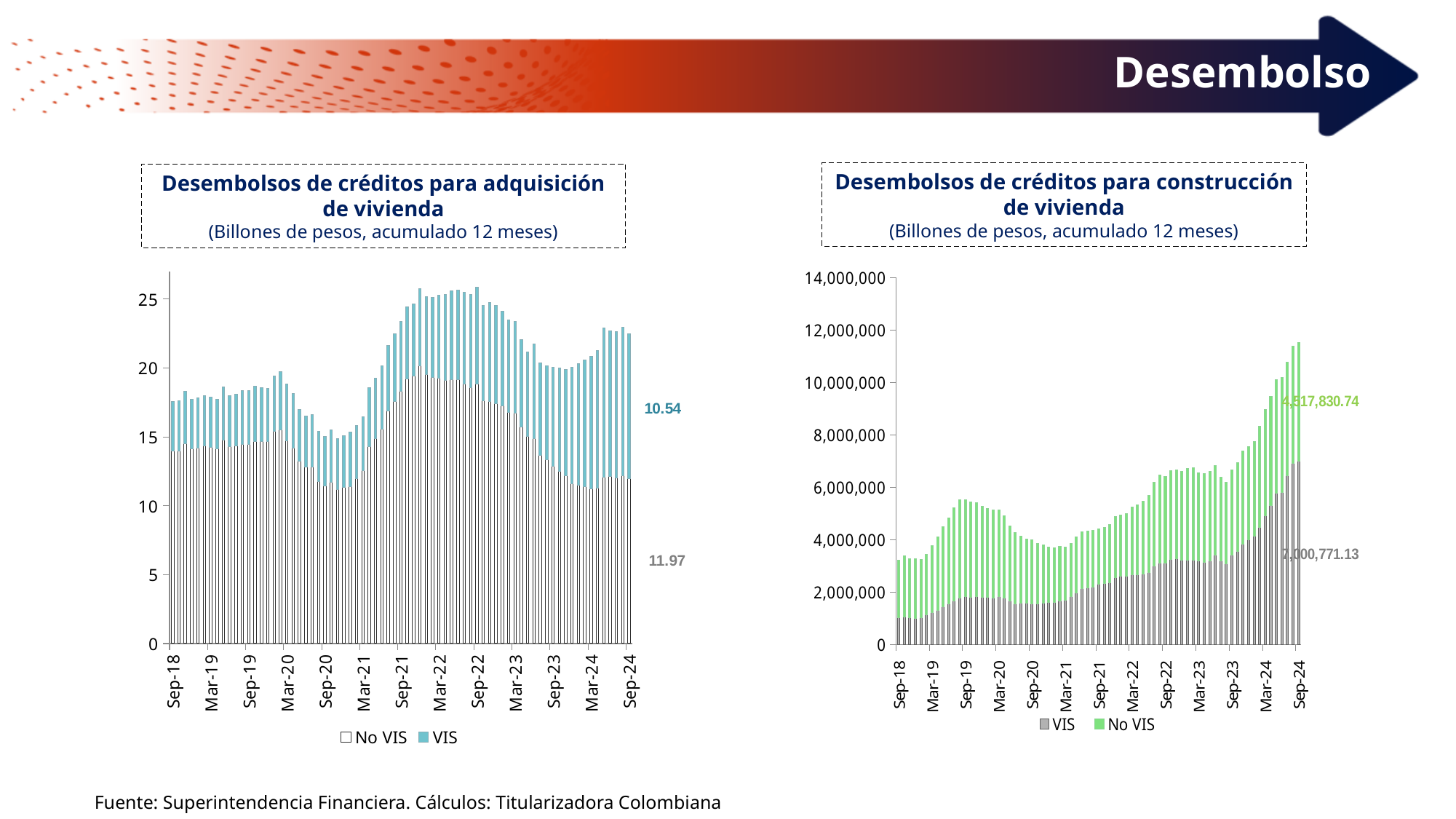
In the chart 'Desembolsos de créditos para construcción de vivienda', which period has the highest total stacked value? Sep-24 In the chart 'Desembolsos de créditos para adquisición de vivienda', what is the VIS value labelled at Sep-24? 10.54 What kind of chart is 'Desembolsos de créditos para adquisición de vivienda'? Stacked bar chart In the chart 'Desembolsos de créditos para adquisición de vivienda', which is larger at Sep-24, VIS or No VIS? No VIS How many series does the legend of the chart 'Desembolsos de créditos para construcción de vivienda' list? 2 In the chart 'Desembolsos de créditos para adquisición de vivienda', what is the total of the stacked bar at Sep-24 using the two labelled values? 22.51 In the chart 'Desembolsos de créditos para adquisición de vivienda', what is the No VIS value labelled at Sep-24? 11.97 In the chart 'Desembolsos de créditos para adquisición de vivienda', is the total stacked value at Sep-18 greater or less than 20? less In the chart 'Desembolsos de créditos para adquisición de vivienda', what is the difference between the No VIS and VIS values labelled at Sep-24? 1.43 In the chart 'Desembolsos de créditos para construcción de vivienda', do the total values rise or fall from Sep-23 to Sep-24? rise In the chart 'Desembolsos de créditos para construcción de vivienda', is the total stacked value at Sep-24 greater or less than 10,000,000? greater In the chart 'Desembolsos de créditos para construcción de vivienda', is the total stacked value at Sep-18 greater or less than 4,000,000? less